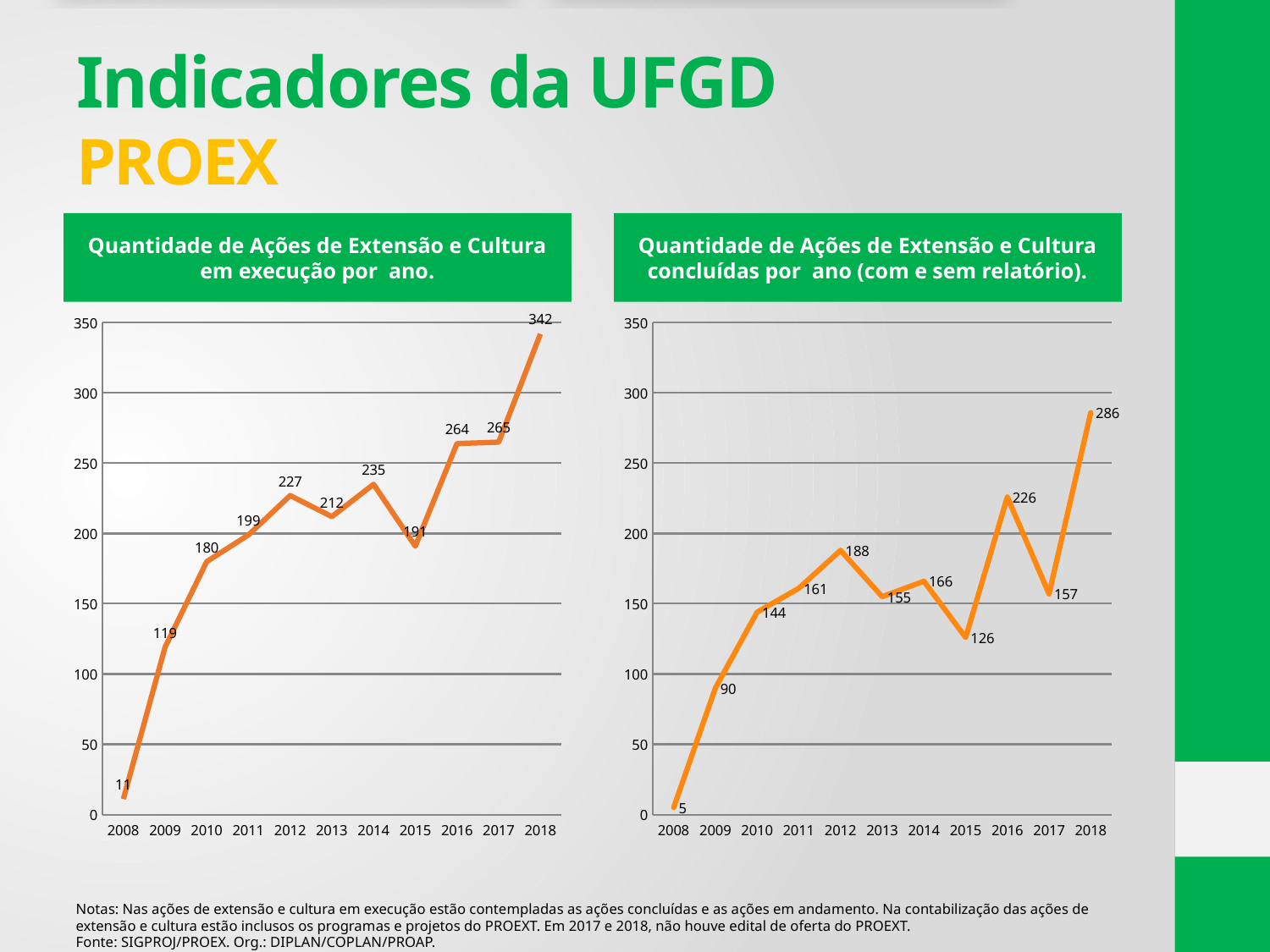
In the left chart (em execução por ano), what is the difference between the values for 2018 and 2017? 77 In the left chart (em execução por ano), is the value for 2015 greater or less than 200? less How many years are plotted in the left chart (em execução por ano)? 11 In the left chart (em execução por ano), do the values rise or fall from 2008 to 2010? Rise In the right chart (concluídas por ano), which year has the larger value, 2014 or 2015? 2014 In the right chart (concluídas por ano), what is the difference between the values for 2012 and 2013? 33 In the left chart (em execução por ano), which year has the highest value? 2018 In the left chart (em execução por ano), what is the value for 2014? 235 What is the title of the right chart? Quantidade de Ações de Extensão e Cultura concluídas por ano (com e sem relatório). In the right chart (concluídas por ano), what is the value for 2016? 226 What kind of chart is the right chart (concluídas por ano)? Line chart In the right chart (concluídas por ano), which year has the lowest value? 2008